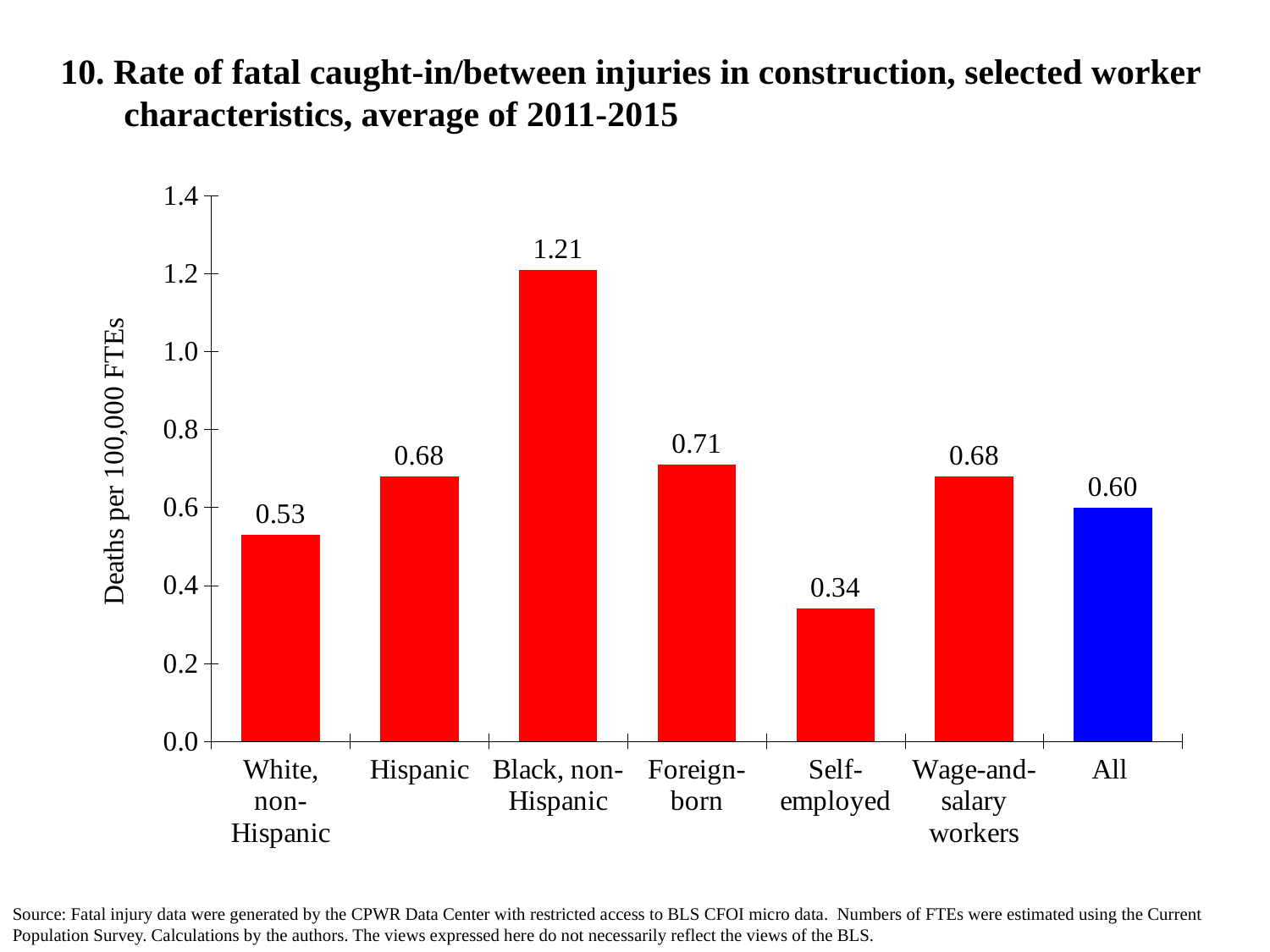
What is the value shown for Self-employed workers? 0.34 Which is larger, the rate for Foreign-born workers or the rate for Hispanic workers? Foreign-born What is the difference between the rates for Black, non-Hispanic and White, non-Hispanic workers? 0.68 What is the value shown for the All category? 0.60 What is the value shown for Foreign-born workers? 0.71 What is the label of the vertical axis? Deaths per 100,000 FTEs How many worker categories are shown in the chart? 7 Which worker category has the lowest rate? Self-employed Which worker category has the highest rate? Black, non-Hispanic What is the rate of fatal caught-in/between injuries for Black, non-Hispanic workers? 1.21 Is the value for Wage-and-salary workers greater or less than 0.6? greater What kind of chart is shown on the slide? Bar chart